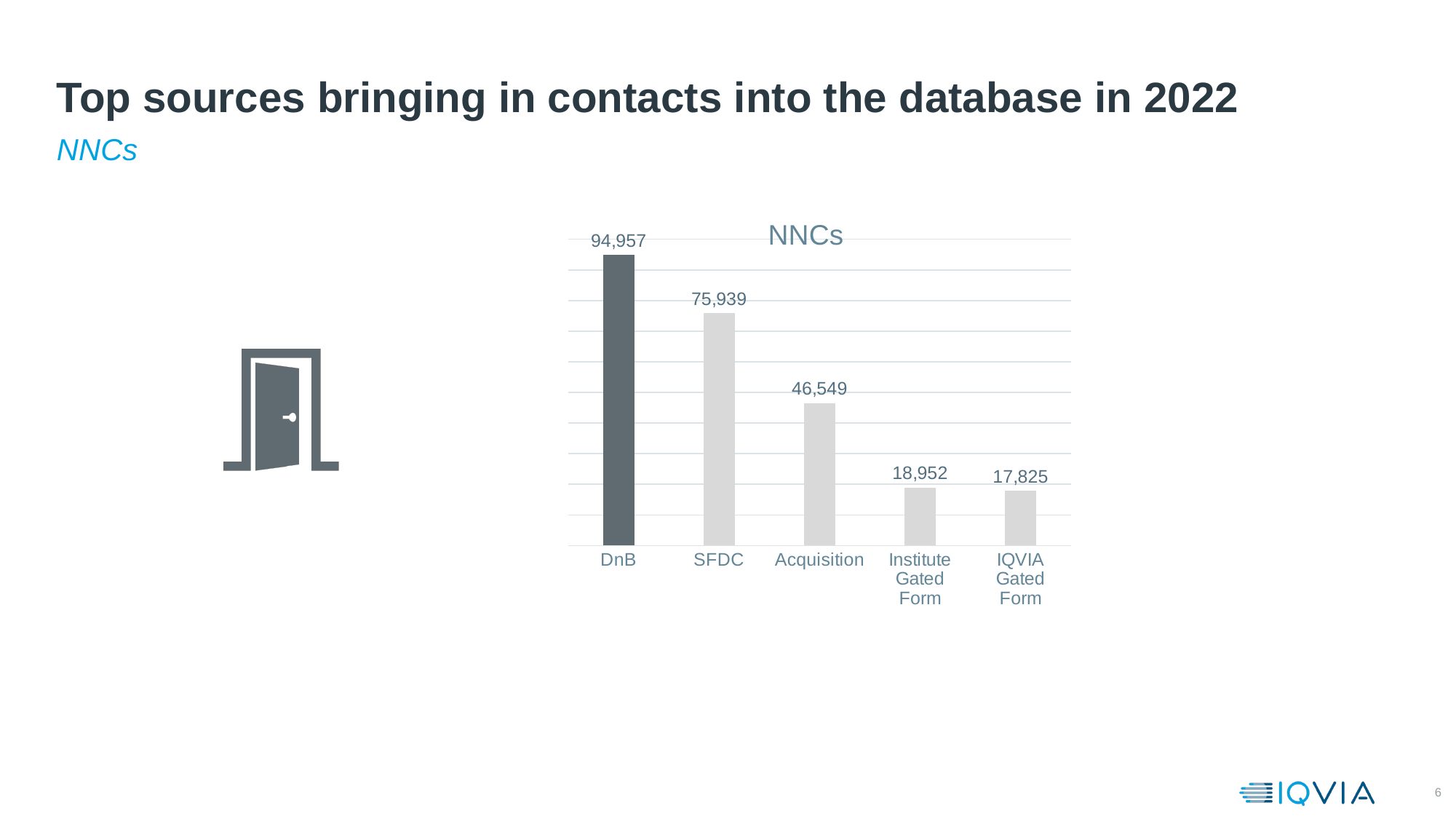
What kind of chart is shown on the slide? Bar chart What is the difference between the values for SFDC and Acquisition? 29,390 What is the value for Acquisition? 46,549 What is the value for DnB? 94,957 Which source has the lowest value? IQVIA Gated Form Which source has the highest value? DnB What is the value for IQVIA Gated Form? 17,825 Which is larger, the value for Acquisition or the value for Institute Gated Form? Acquisition What is the value for SFDC? 75,939 What is the difference between the values for DnB and SFDC? 19,018 How many sources are shown in the chart? 5 What is the value for Institute Gated Form? 18,952